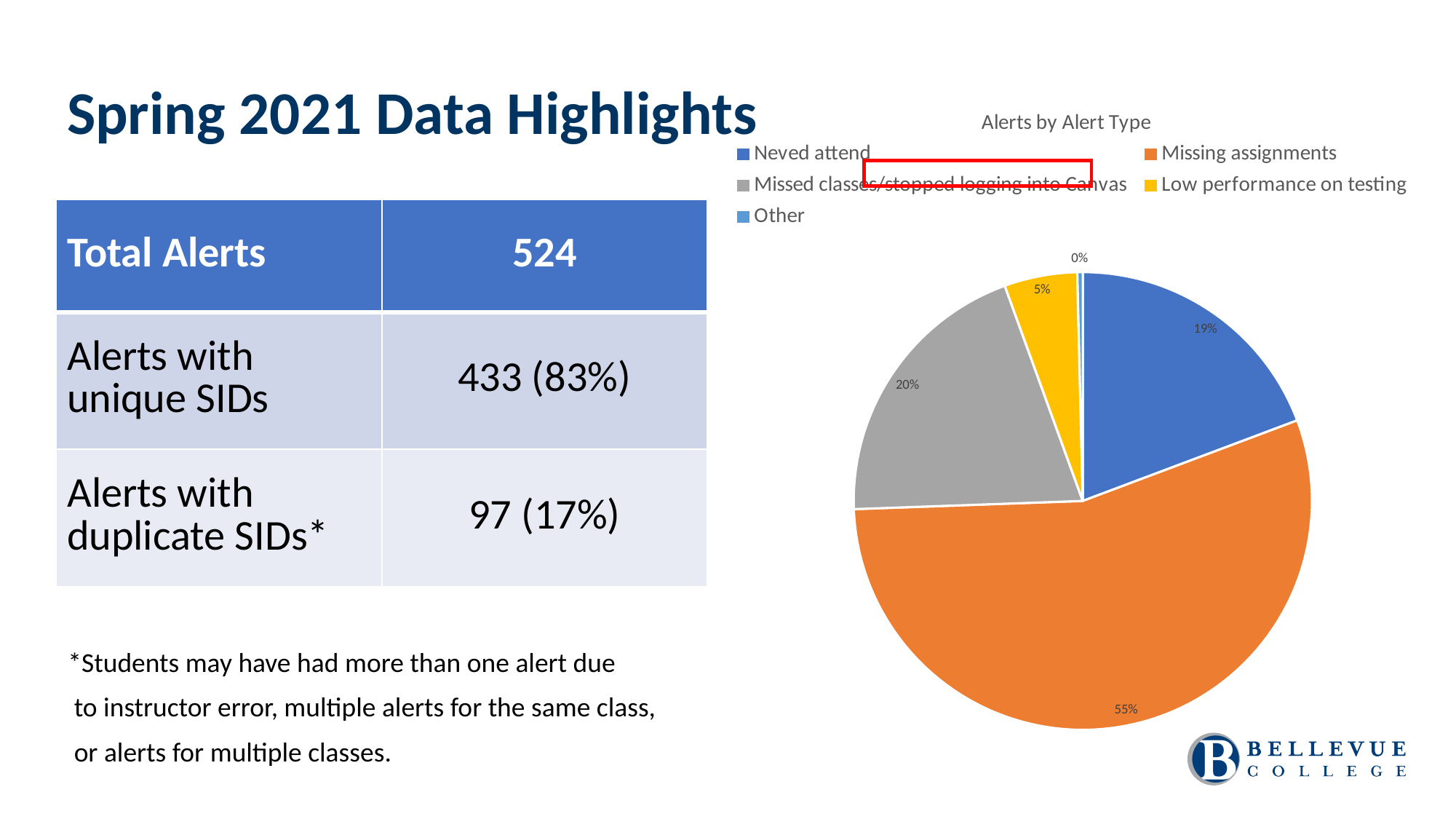
What is the title of the chart? Alerts by Alert Type What share of alerts is Missed classes/stopped logging into Canvas? 20% What share of alerts is Low performance on testing? 5% Which is larger, the share for Missing assignments or the share for Neved attend? Missing assignments What kind of chart is shown on the slide? pie chart What share of alerts is Neved attend? 19% How many alert types does the legend list? 5 Which alert type has the largest share of the pie? Missing assignments What is the difference between the share for Missed classes/stopped logging into Canvas and the share for Low performance on testing? 15% Which alert type has the smallest share of the pie? Other